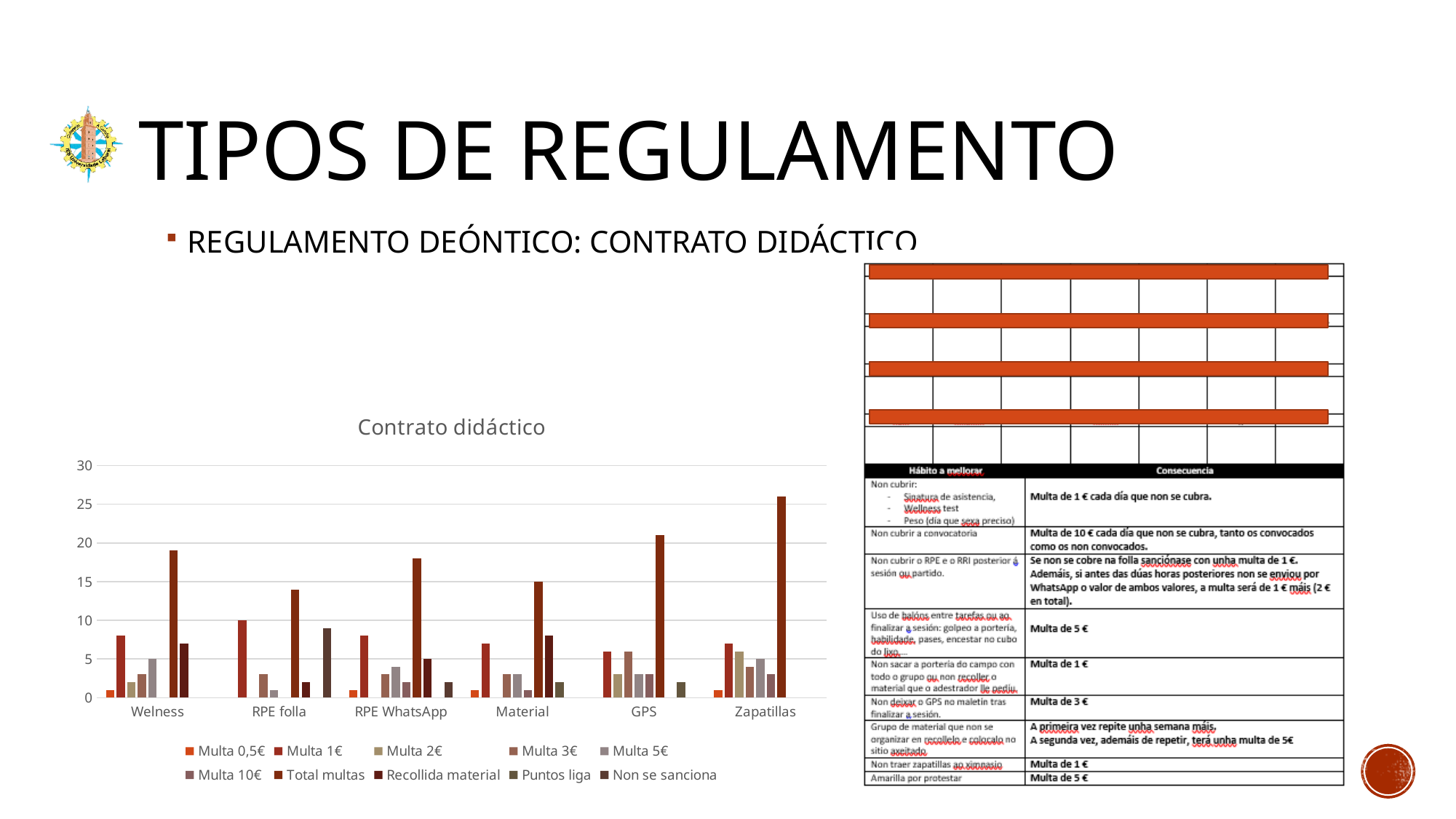
What kind of chart is the 'Contrato didáctico' chart? bar chart In the 'Contrato didáctico' chart, which category has the highest 'Multa 1€' bar? RPE folla In the 'Contrato didáctico' chart, which category has the highest 'Total multas' bar? Zapatillas What is the first entry in the legend of the 'Contrato didáctico' chart? Multa 0,5€ In the 'Contrato didáctico' chart, is the 'Total multas' value for RPE WhatsApp greater or less than 20? less How many categories are shown on the x axis of the 'Contrato didáctico' chart? 6 In the 'Contrato didáctico' chart, is the 'Total multas' value for Zapatillas greater or less than 25? greater How many series does the legend of the 'Contrato didáctico' chart list? 10 In the 'Contrato didáctico' chart, is the 'Total multas' value for Material greater or less than 10? greater In the 'Contrato didáctico' chart, is the 'Total multas' bar larger for Welness or for RPE folla? Welness What is the title of the bar chart on the slide? Contrato didáctico In the 'Contrato didáctico' chart, is the 'Total multas' bar larger for Zapatillas or for GPS? Zapatillas